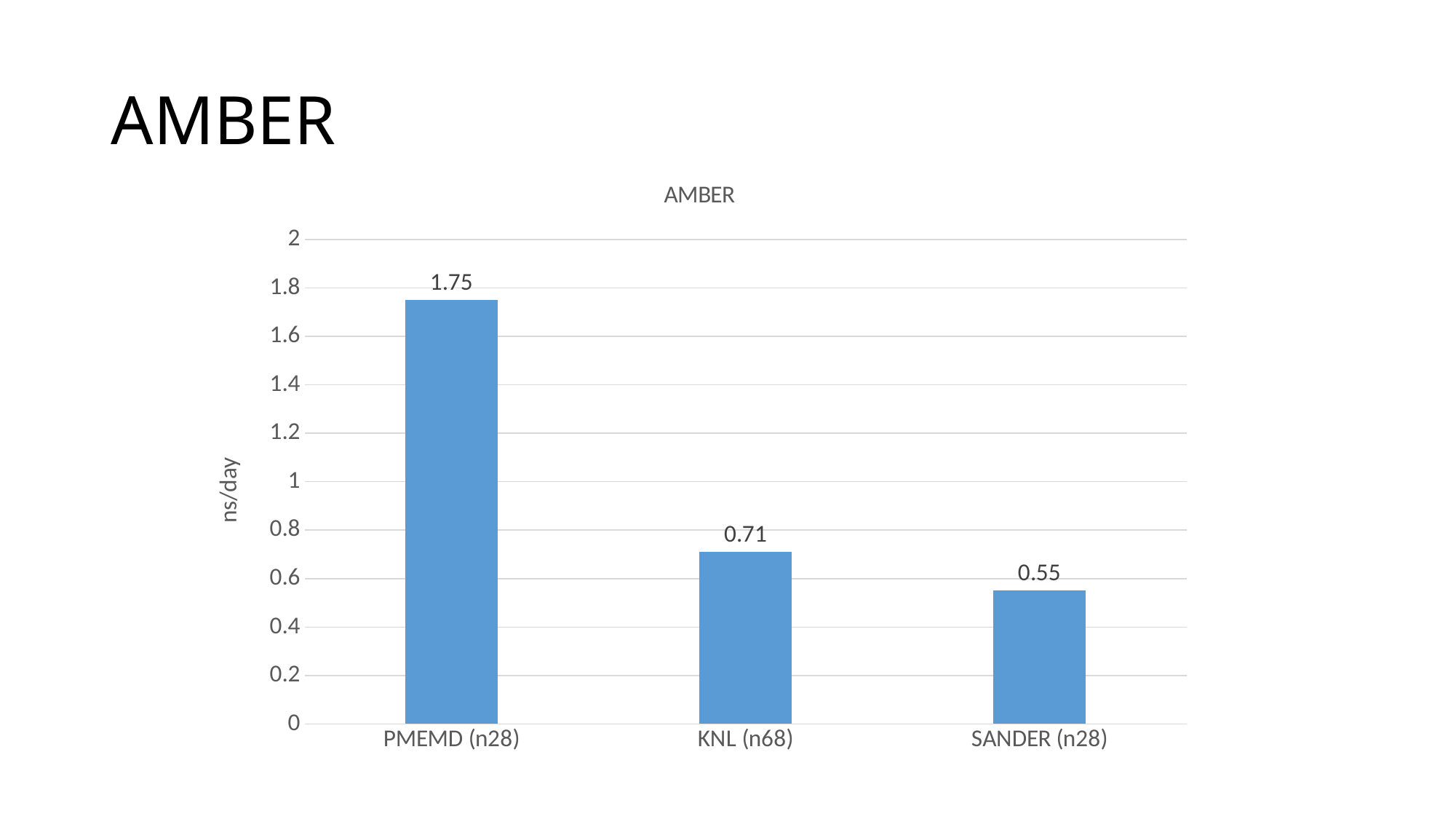
Which category has the lowest value? SANDER (n28) What kind of chart is shown on the slide? bar chart What is the label of the y axis? ns/day Is the value for PMEMD (n28) greater or less than 1? greater Which category has the highest value? PMEMD (n28) What is the value for SANDER (n28)? 0.55 What is the difference between the values for PMEMD (n28) and KNL (n68)? 1.04 What is the value for PMEMD (n28)? 1.75 How many categories are shown on the x axis? 3 What is the difference between the values for KNL (n68) and SANDER (n28)? 0.16 What is the value for KNL (n68)? 0.71 Which is larger, the value for KNL (n68) or the value for SANDER (n28)? KNL (n68)